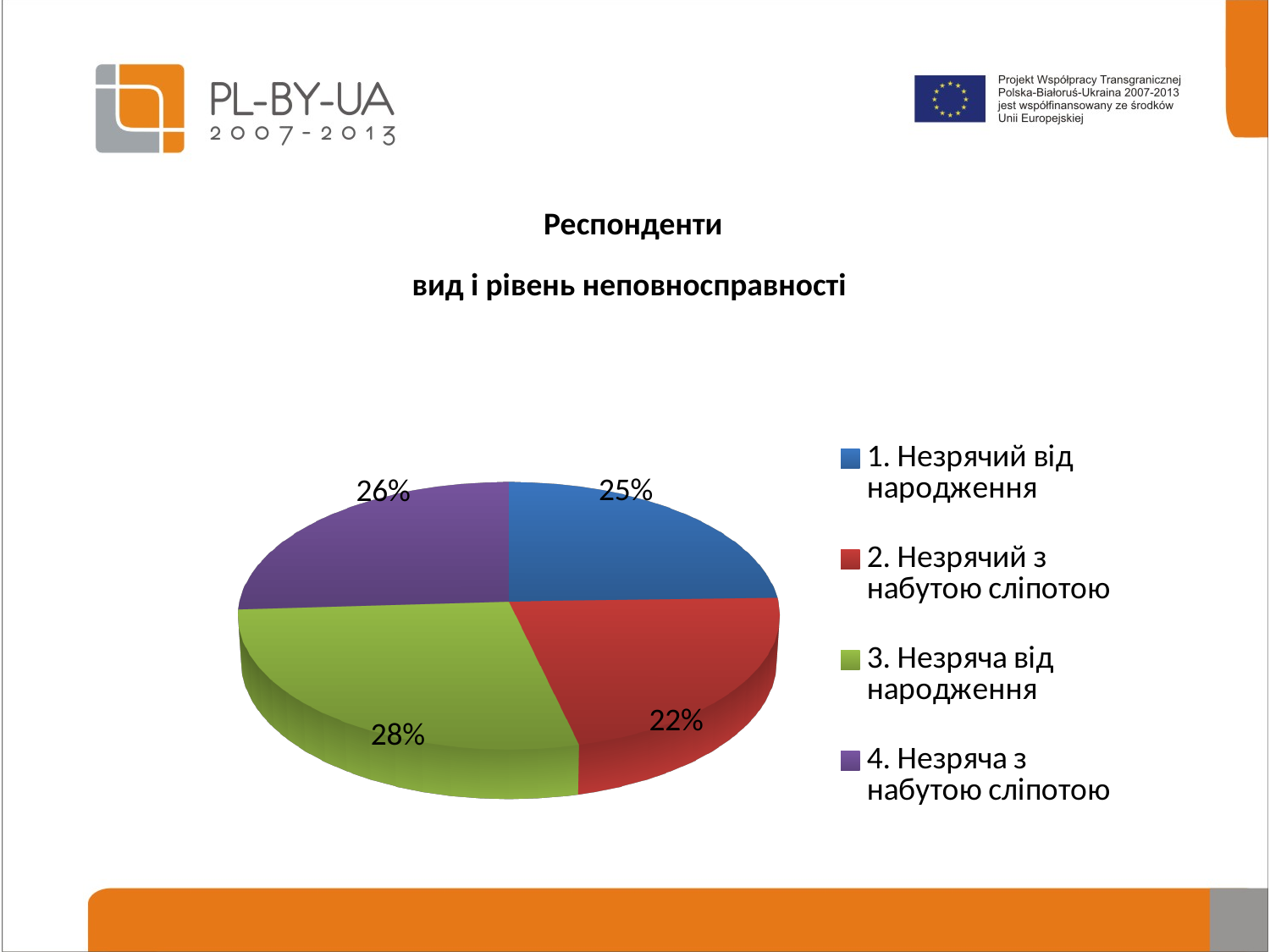
How many slices does the pie chart have? 4 What is the difference in percentage points between "3. Незряча від народження" and "2. Незрячий з набутою сліпотою"? 6 What share of the pie does "3. Незряча від народження" have? 28% Which category has the largest slice of the pie? 3. Незряча від народження What is the title of the chart? Респонденти вид і рівень неповносправності What share of the pie does "1. Незрячий від народження" have? 25% What share of the pie does "4. Незряча з набутою сліпотою" have? 26% What kind of chart is shown on the slide? pie chart Which is larger: the share for "4. Незряча з набутою сліпотою" or the share for "1. Незрячий від народження"? 4. Незряча з набутою сліпотою Which category has the smallest slice of the pie? 2. Незрячий з набутою сліпотою What colour is the slice for "4. Незряча з набутою сліпотою"? purple